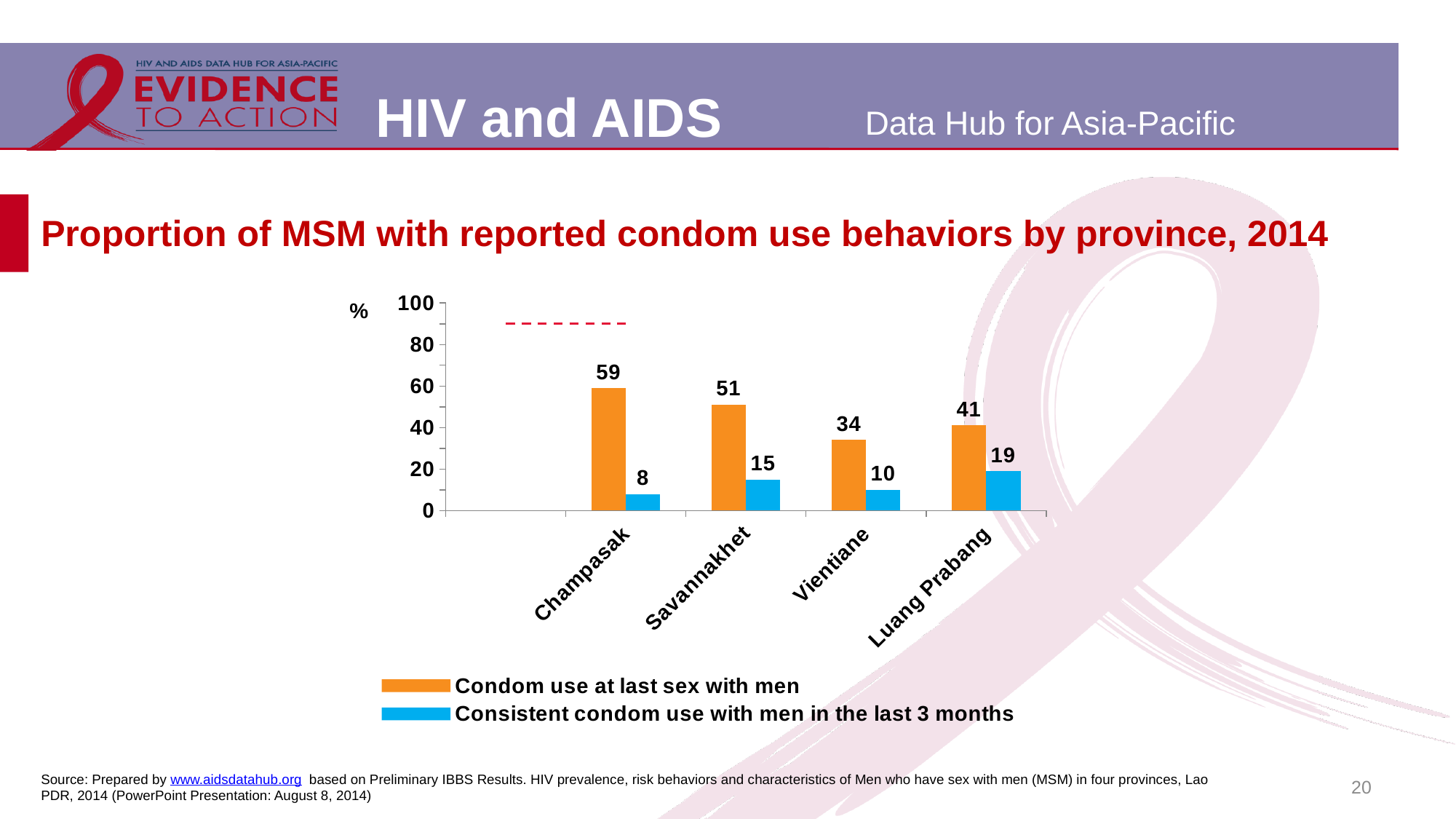
Which colour represents 'Consistent condom use with men in the last 3 months' in the legend? Blue What kind of chart is shown on the slide? Bar chart What is the value for 'Consistent condom use with men in the last 3 months' in Savannakhet? 15 What is the value for 'Consistent condom use with men in the last 3 months' in Luang Prabang? 19 Which province has the highest value for 'Condom use at last sex with men'? Champasak Which is larger: 'Condom use at last sex with men' in Savannakhet or in Luang Prabang? Savannakhet What is the difference between 'Condom use at last sex with men' and 'Consistent condom use with men in the last 3 months' in Vientiane? 24 Which province has the lowest value for 'Consistent condom use with men in the last 3 months'? Champasak How many provinces are shown on the x axis? 4 What is the value for 'Condom use at last sex with men' in Champasak? 59 How many series does the legend list? 2 Is the value for 'Condom use at last sex with men' in Vientiane greater or less than 40? less